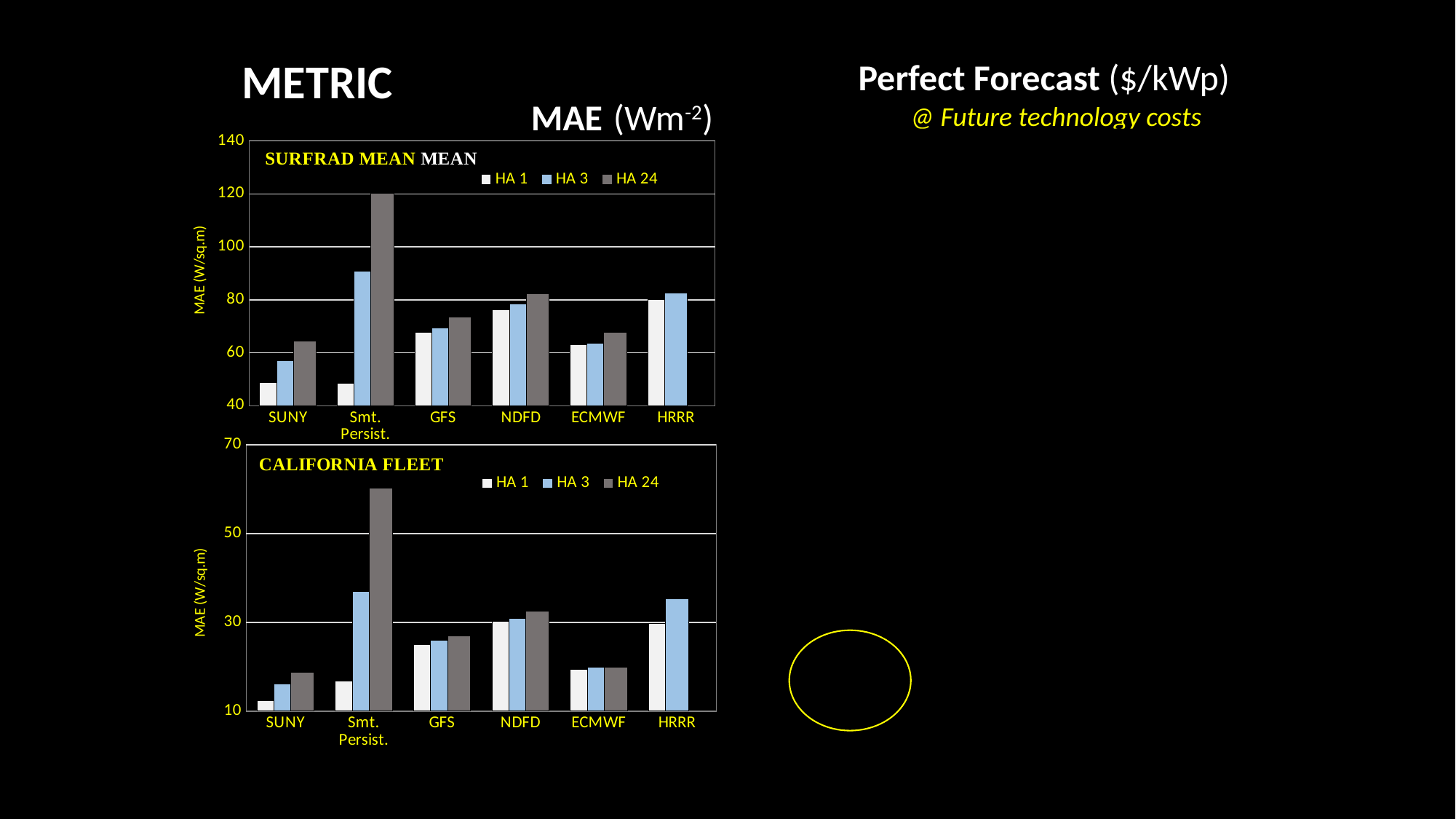
How many categories are shown on the x axis of the SURFRAD MEAN MEAN chart? 6 In the CALIFORNIA FLEET chart, which is larger: the HA 3 value for Smt. Persist. or the HA 3 value for NDFD? Smt. Persist. In the CALIFORNIA FLEET chart, is the HA 3 value for HRRR greater or less than 30? greater In the CALIFORNIA FLEET chart, which category has the lowest HA 1 value? SUNY In the SURFRAD MEAN MEAN chart, is the HA 3 value for Smt. Persist. greater or less than 80? greater In the SURFRAD MEAN MEAN chart, which category has the highest HA 24 value? Smt. Persist. In the CALIFORNIA FLEET chart, is the HA 24 value for Smt. Persist. greater or less than 50? greater In the CALIFORNIA FLEET chart, which category has the highest HA 24 value? Smt. Persist. What are the three legend entries in the SURFRAD MEAN MEAN chart? HA 1, HA 3, HA 24 How many series does the legend of the CALIFORNIA FLEET chart list? 3 What kind of chart is the SURFRAD MEAN MEAN chart? bar chart